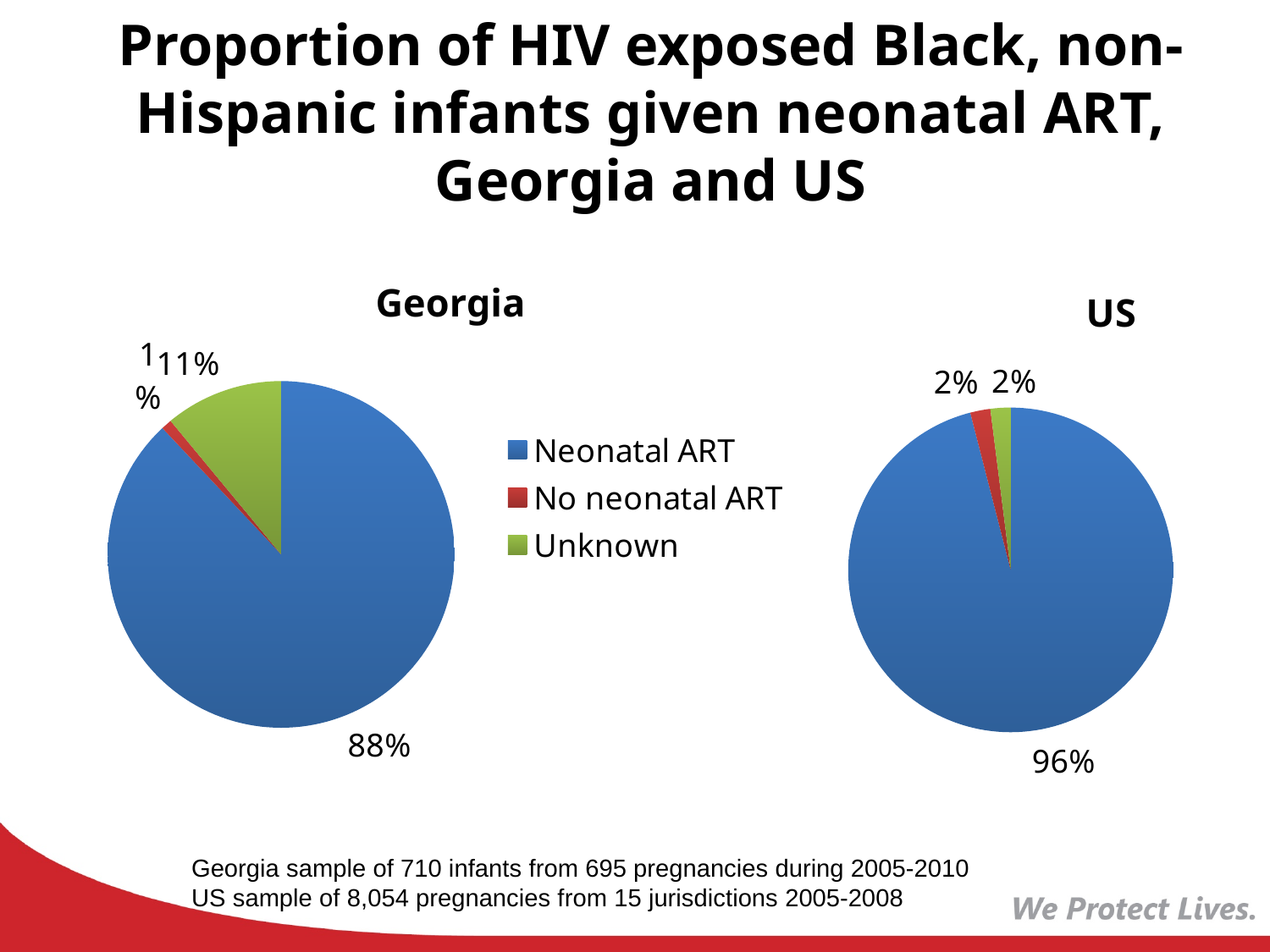
In the Georgia pie chart, what percentage of infants received no neonatal ART? 1% What type of chart is used on this slide? Pie chart In the Georgia pie chart, what percentage is labelled Unknown? 11% In the Georgia pie chart, which category has the smallest slice? No neonatal ART In the US pie chart, what percentage of infants received no neonatal ART? 2% In the Georgia pie chart, which category has the largest slice? Neonatal ART Which has a larger share of infants given neonatal ART, Georgia or the US? US In the US pie chart, which category has the largest slice? Neonatal ART In the US pie chart, what percentage of infants received neonatal ART? 96% In the Georgia pie chart, what percentage of infants received neonatal ART? 88% What is the difference between the US and Georgia percentages of infants given neonatal ART? 8% How many categories does the legend list? 3